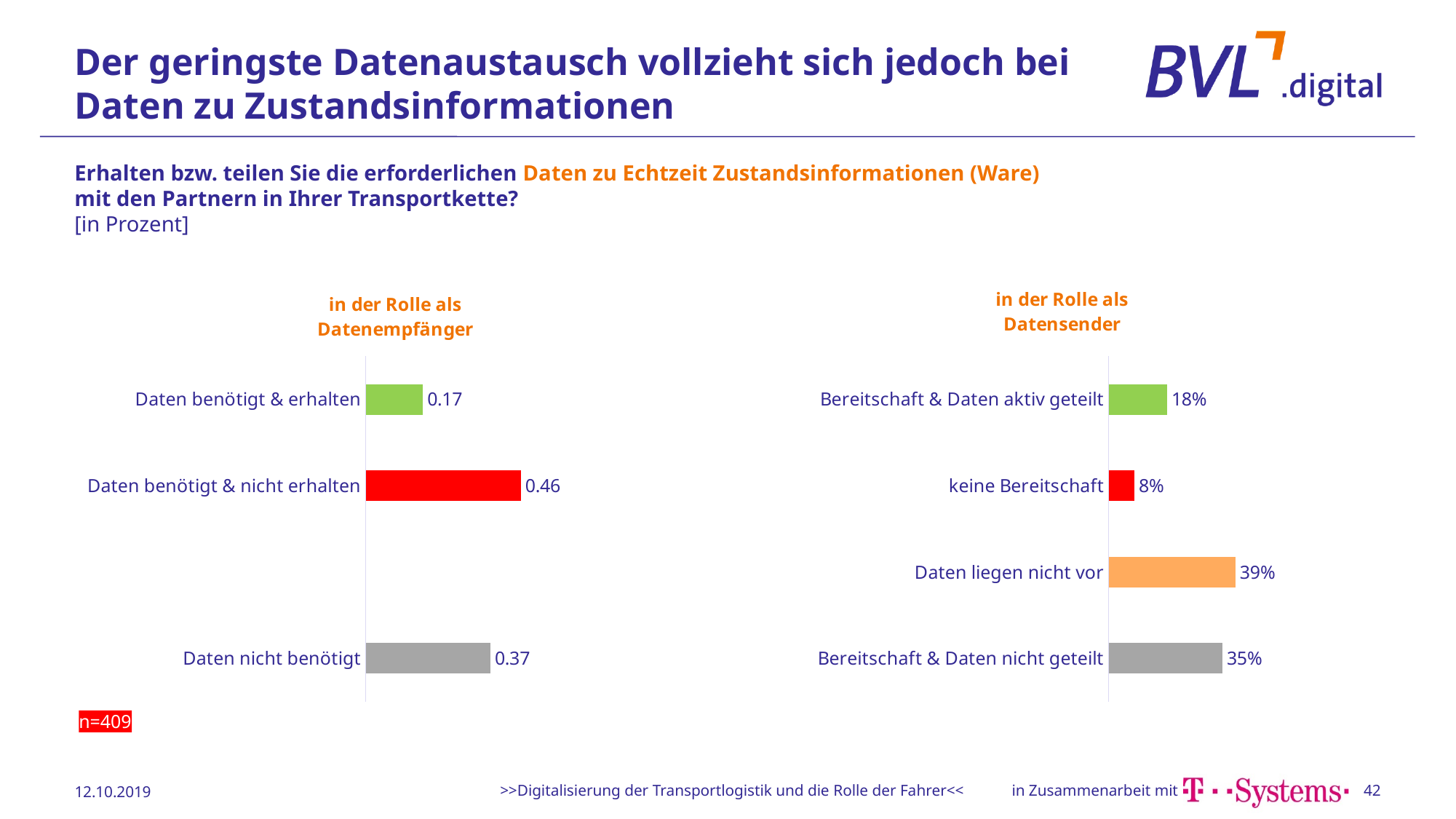
In the 'in der Rolle als Datenempfänger' chart, which category has the lowest value? Daten benötigt & erhalten How many bars are shown in the 'in der Rolle als Datenempfänger' chart? 3 In the 'in der Rolle als Datensender' chart, what is the difference between 'Daten liegen nicht vor' and 'Bereitschaft & Daten nicht geteilt'? 4% What type of chart is used on this slide? Bar chart In the 'in der Rolle als Datensender' chart, which is larger: 'Bereitschaft & Daten aktiv geteilt' or 'Bereitschaft & Daten nicht geteilt'? Bereitschaft & Daten nicht geteilt In the 'in der Rolle als Datenempfänger' chart, what is the value for 'Daten nicht benötigt'? 0.37 In the 'in der Rolle als Datenempfänger' chart, what is the difference between 'Daten benötigt & nicht erhalten' and 'Daten benötigt & erhalten'? 0.29 In the 'in der Rolle als Datenempfänger' chart, what is the value for 'Daten benötigt & nicht erhalten'? 0.46 In the 'in der Rolle als Datensender' chart, what is the value for 'keine Bereitschaft'? 8% How many categories are shown in the 'in der Rolle als Datensender' chart? 4 In the 'in der Rolle als Datensender' chart, which category has the highest value? Daten liegen nicht vor In the 'in der Rolle als Datensender' chart, what is the value for 'Daten liegen nicht vor'? 39%